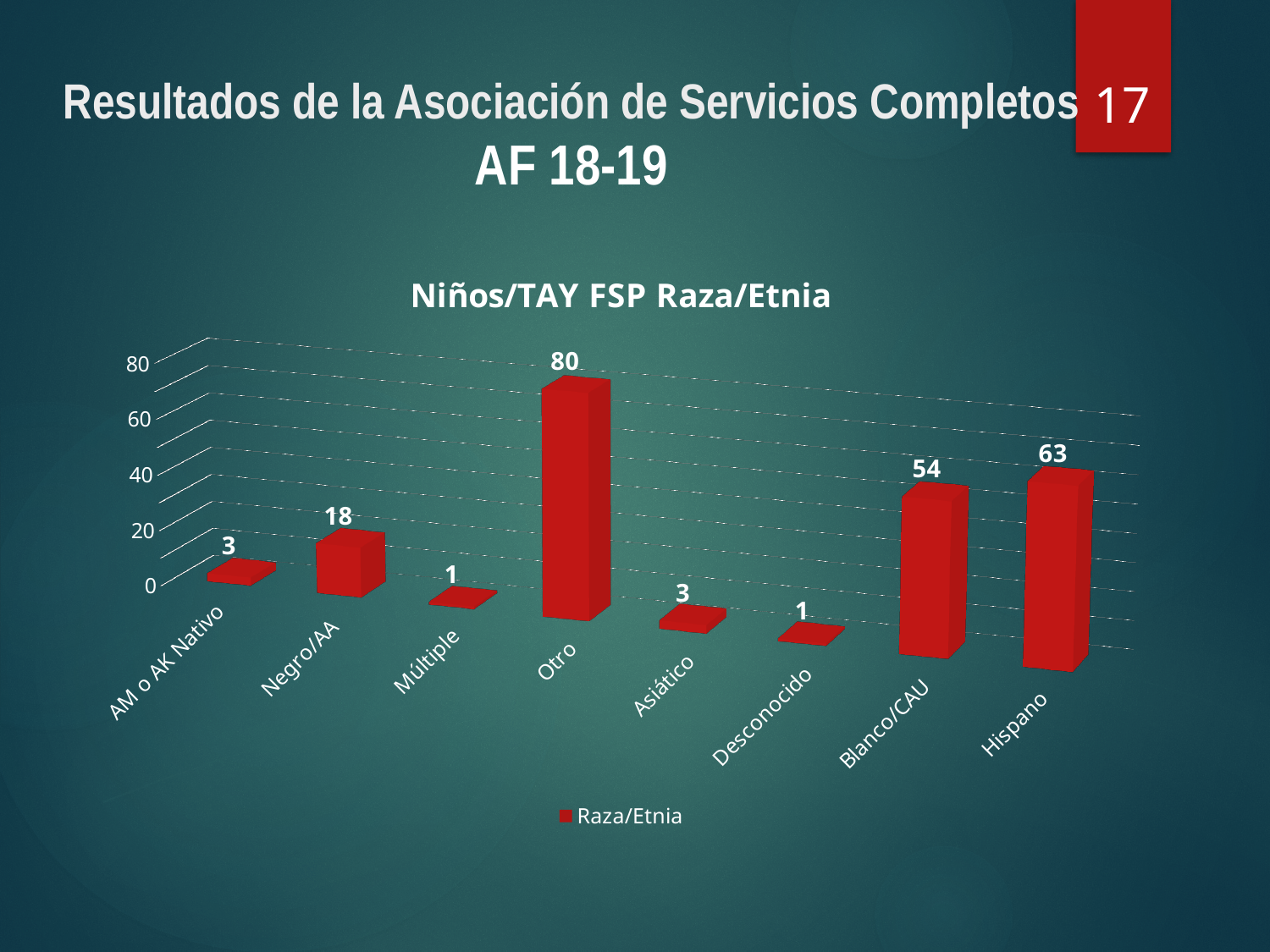
What is the value for Otro? 80 What kind of chart is shown? bar chart What is the value for Negro/AA? 18 How many categories are shown on the x axis? 8 What is the value for Blanco/CAU? 54 What is the value for Hispano? 63 Which is larger, the value for Hispano or the value for Blanco/CAU? Hispano Which category has the highest value? Otro What is the difference between the values for Hispano and Blanco/CAU? 9 What is the title of the chart? Niños/TAY FSP Raza/Etnia Is the value for Blanco/CAU greater or less than 40? greater What is the difference between the values for Otro and Negro/AA? 62